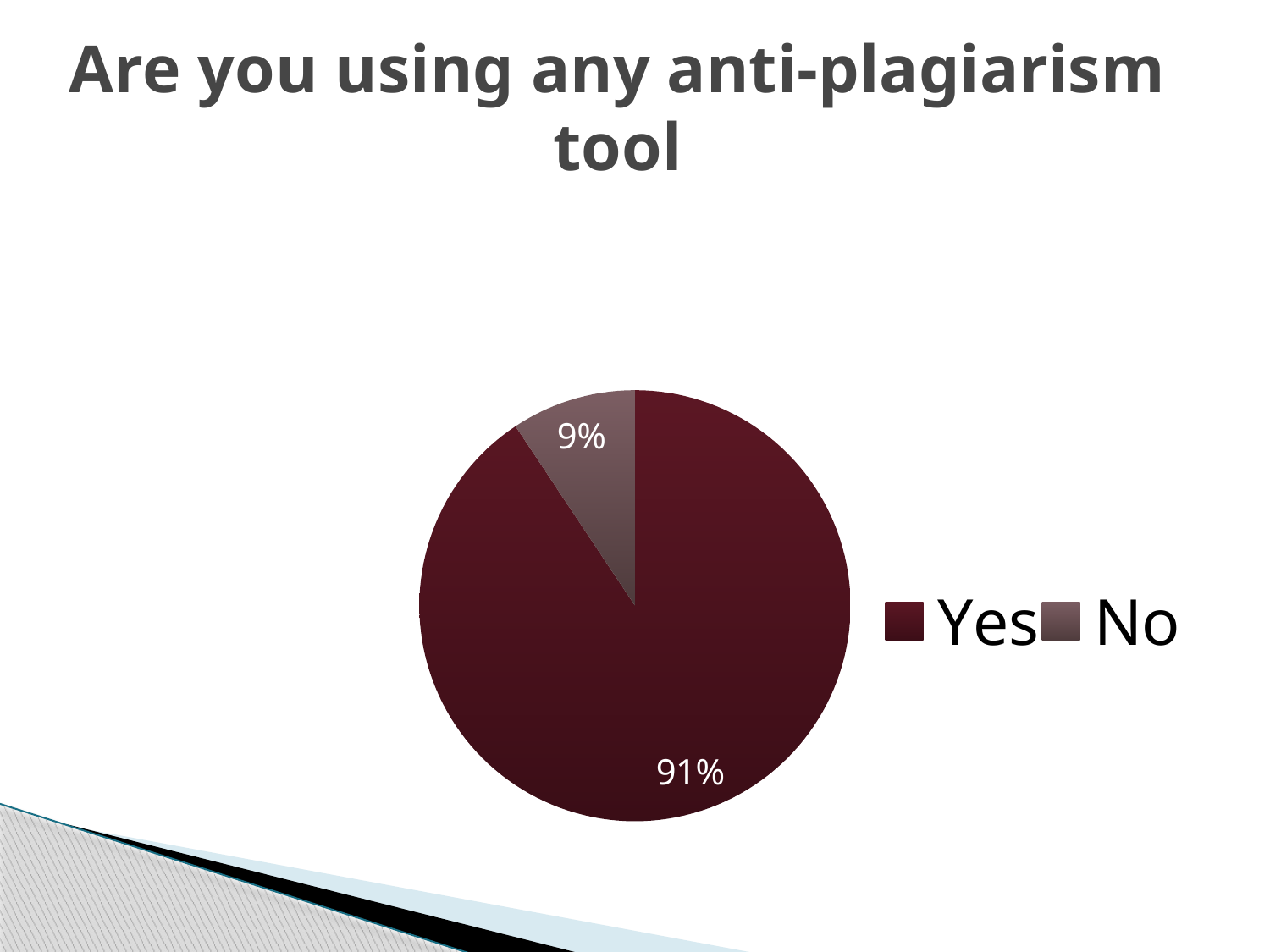
Which response has the smallest share of the pie? No How many entries does the legend list? 2 What percentage of respondents answered Yes? 91% What are the two legend entries shown on the slide? Yes and No Which slice is larger, Yes or No? Yes What percentage of respondents answered No? 9% What is the title of the chart? Are you using any anti-plagiarism tool How many slices does the pie chart have? 2 What share of the pie does the No slice represent? 9% What kind of chart is shown on the slide? pie chart What is the difference in percentage points between the Yes and No slices? 82 Which response has the largest share of the pie? Yes